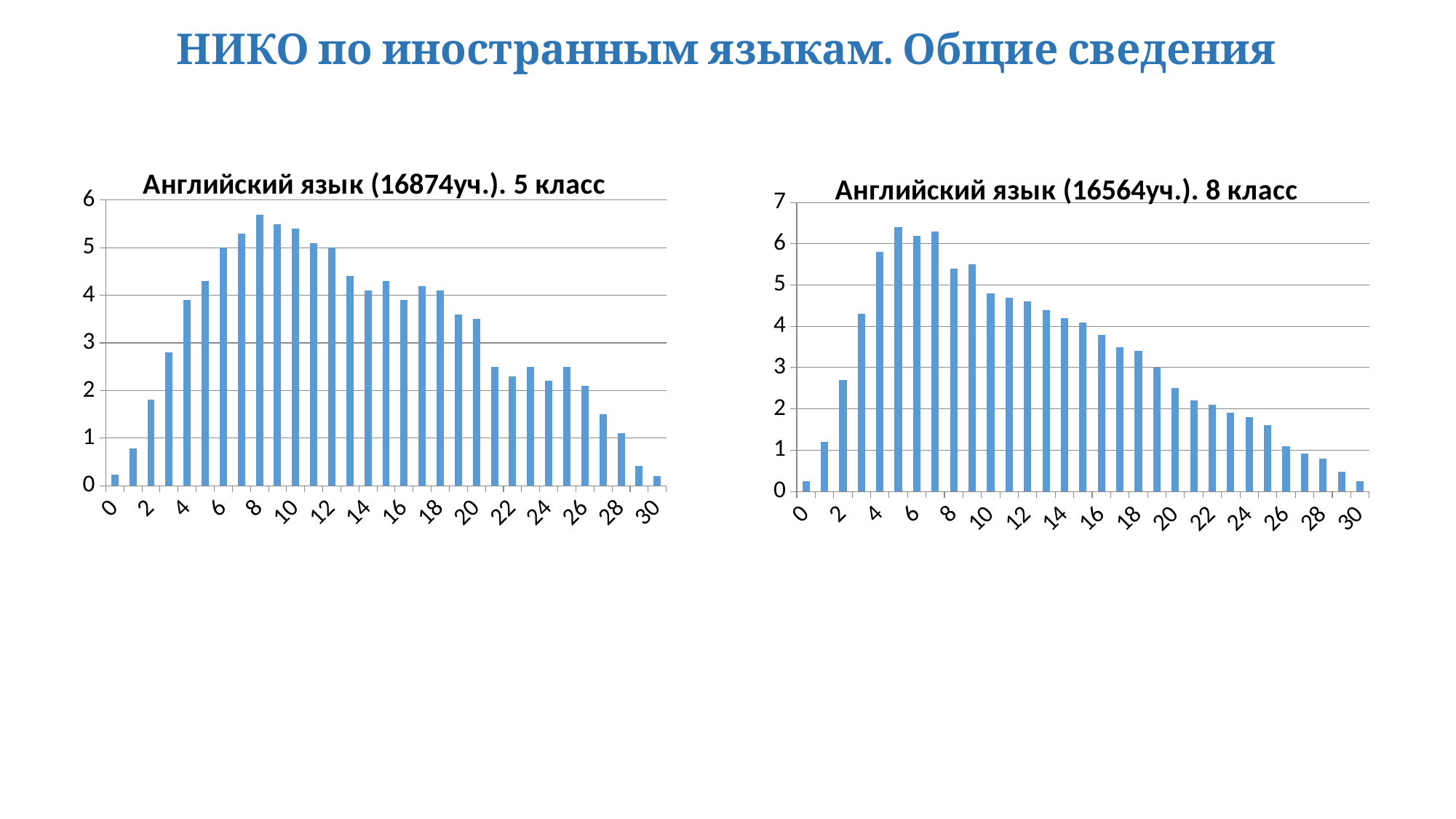
In the right chart (8 класс), do the values rise or fall along the x axis from 10 to 30? fall In the right chart (8 класс), is the value for 10 greater or less than 4? greater In the right chart (8 класс), which is larger, the value for 3 or the value for 20? 3 In the right chart (8 класс), is the value for 5 greater or less than 6? greater What kind of chart is the left chart, 'Английский язык (16874уч.). 5 класс'? bar chart In the left chart (5 класс), is the value for 8 greater or less than 5? greater In the left chart (5 класс), which score on the x axis has the highest bar? 8 In the left chart (5 класс), which is larger, the value for 4 or the value for 24? 4 How many bars are plotted in the right chart (8 класс), for scores 0 through 30? 31